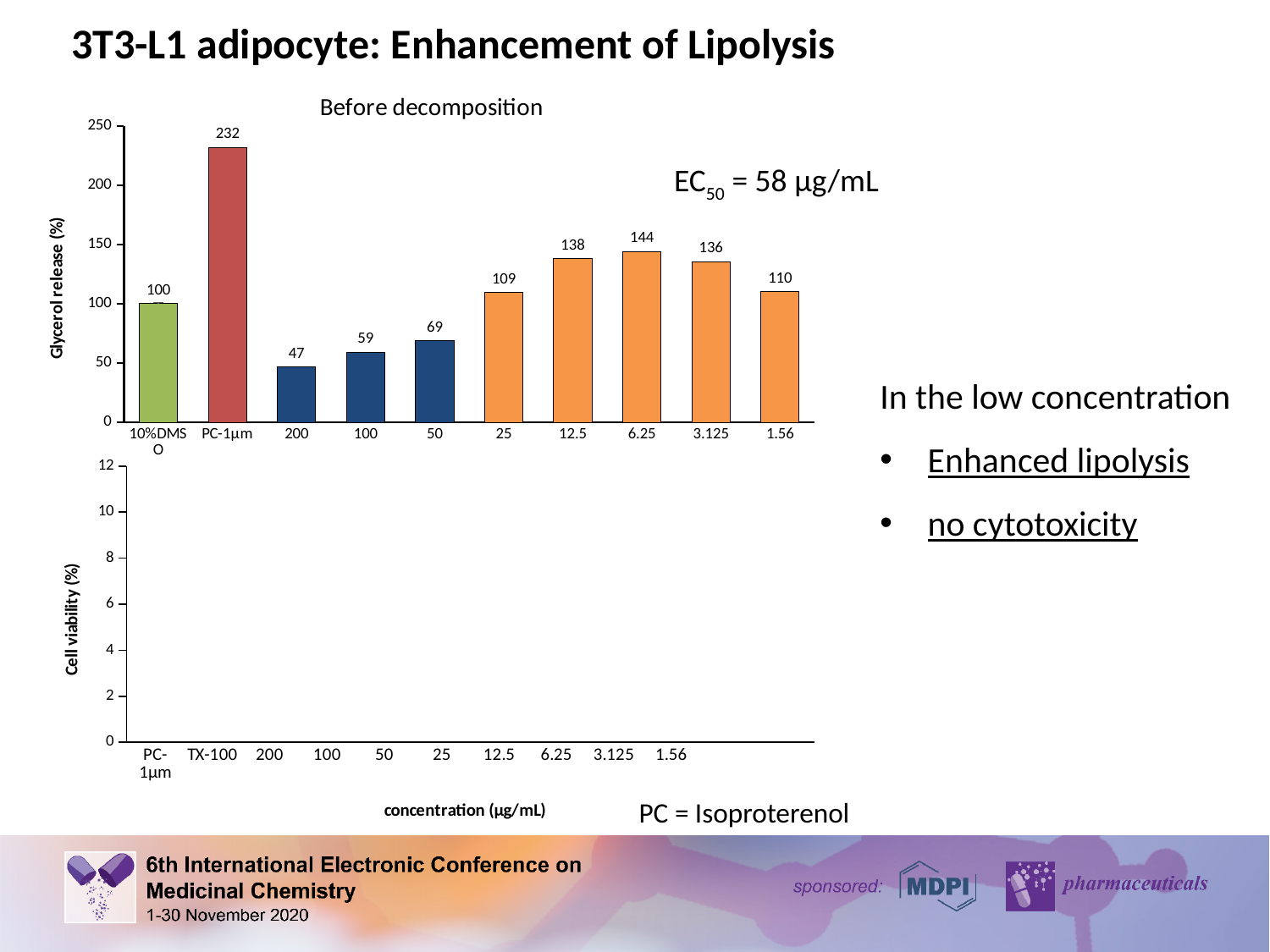
How many categories are shown on the x axis of the 'Before decomposition' chart? 10 In the 'Before decomposition' chart, which category has the highest glycerol release? PC-1µm In the 'Before decomposition' chart, what is the difference between the glycerol release at 6.25 µg/mL and at 3.125 µg/mL? 8 In the 'Before decomposition' chart, what is the difference between the PC-1µm value and the 10%DMSO value? 132 In the 'Before decomposition' chart, what is the glycerol release value for PC-1µm? 232 In the 'Before decomposition' chart, what is the glycerol release value at 200 µg/mL? 47 In the 'Before decomposition' chart, what is the glycerol release value for 10%DMSO? 100 In the 'Before decomposition' chart, do the values rise or fall going from 200 µg/mL to 50 µg/mL? rise In the 'Before decomposition' chart, which has a higher glycerol release: 12.5 µg/mL or 1.56 µg/mL? 12.5 In the 'Before decomposition' chart, which category has the lowest glycerol release? 200 What kind of chart is the 'Before decomposition' chart? bar chart What is the y-axis label of the top chart on the slide? Glycerol release (%)